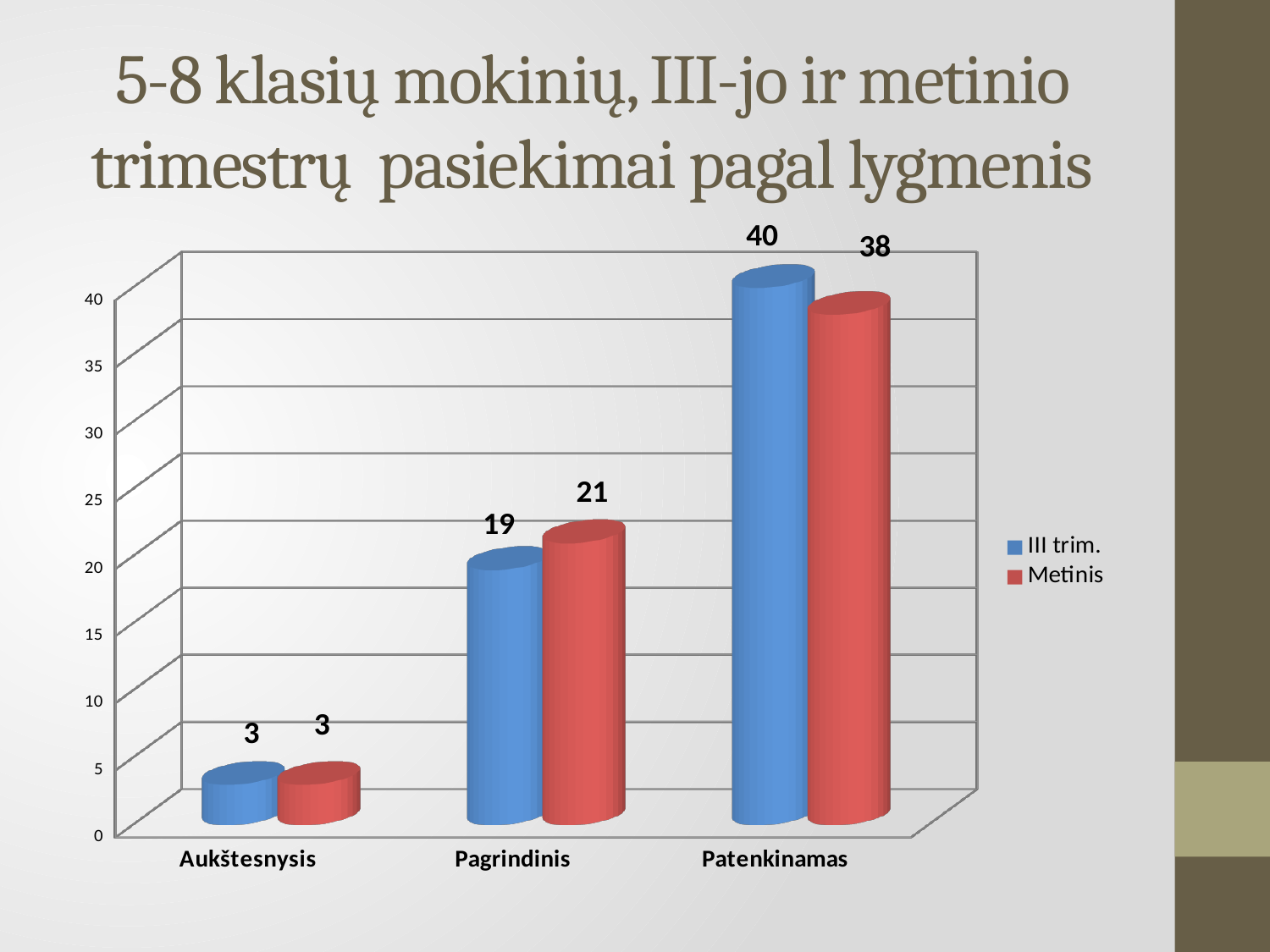
Which category has the highest value for III trim.? Patenkinamas How many series does the legend list? 2 What is the difference between the Metinis and III trim. values in the Pagrindinis category? 2 What is the value for Metinis in the Patenkinamas category? 38 What is the difference between the III trim. and Metinis values in the Patenkinamas category? 2 What kind of chart is shown on the slide? Bar chart Which colour represents the Metinis series? Red How many categories are shown on the x axis? 3 In the Pagrindinis category, which series has the larger value, III trim. or Metinis? Metinis What is the value for Metinis in the Aukštesnysis category? 3 Which category has the lowest value for Metinis? Aukštesnysis What is the value for III trim. in the Pagrindinis category? 19